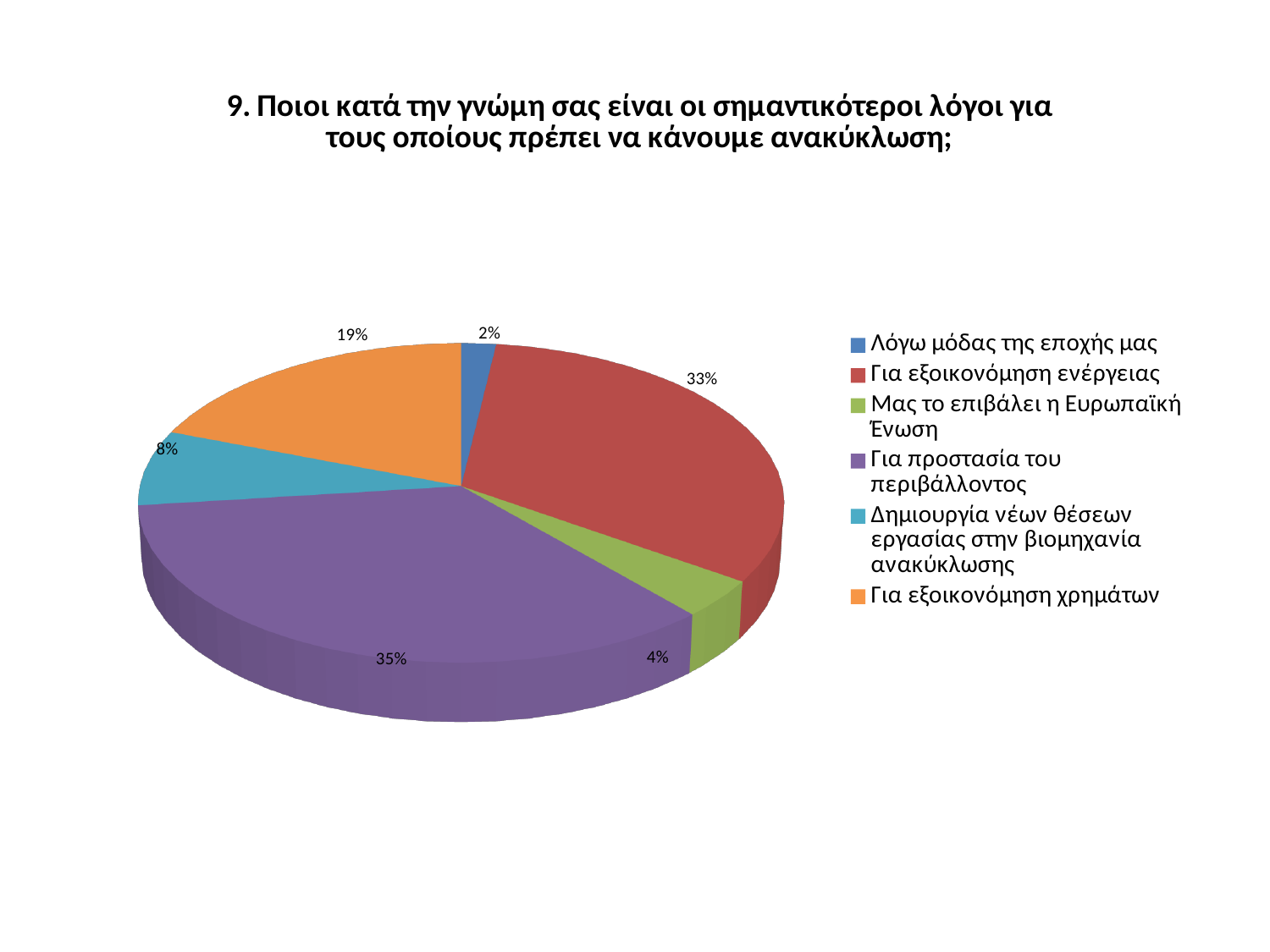
What is the value for "Μας το επιβάλει η Ευρωπαϊκή Ένωση"? 4% What kind of chart is shown on the slide? Pie chart What is the value for "Δημιουργία νέων θέσεων εργασίας στην βιομηχανία ανακύκλωσης"? 8% What share of the pie does "Για εξοικονόμηση ενέργειας" have? 33% Which is larger, the share for "Για εξοικονόμηση χρημάτων" or the share for "Δημιουργία νέων θέσεων εργασίας στην βιομηχανία ανακύκλωσης"? Για εξοικονόμηση χρημάτων Which category has the smallest slice of the pie? Λόγω μόδας της εποχής μας Which category has the largest slice of the pie? Για προστασία του περιβάλλοντος What share of the pie does "Για προστασία του περιβάλλοντος" have? 35% How many categories does the legend list? 6 What is the value for "Για εξοικονόμηση χρημάτων"? 19% What is the difference between the shares for "Για προστασία του περιβάλλοντος" and "Για εξοικονόμηση χρημάτων"? 16% What is the value for "Λόγω μόδας της εποχής μας"? 2%